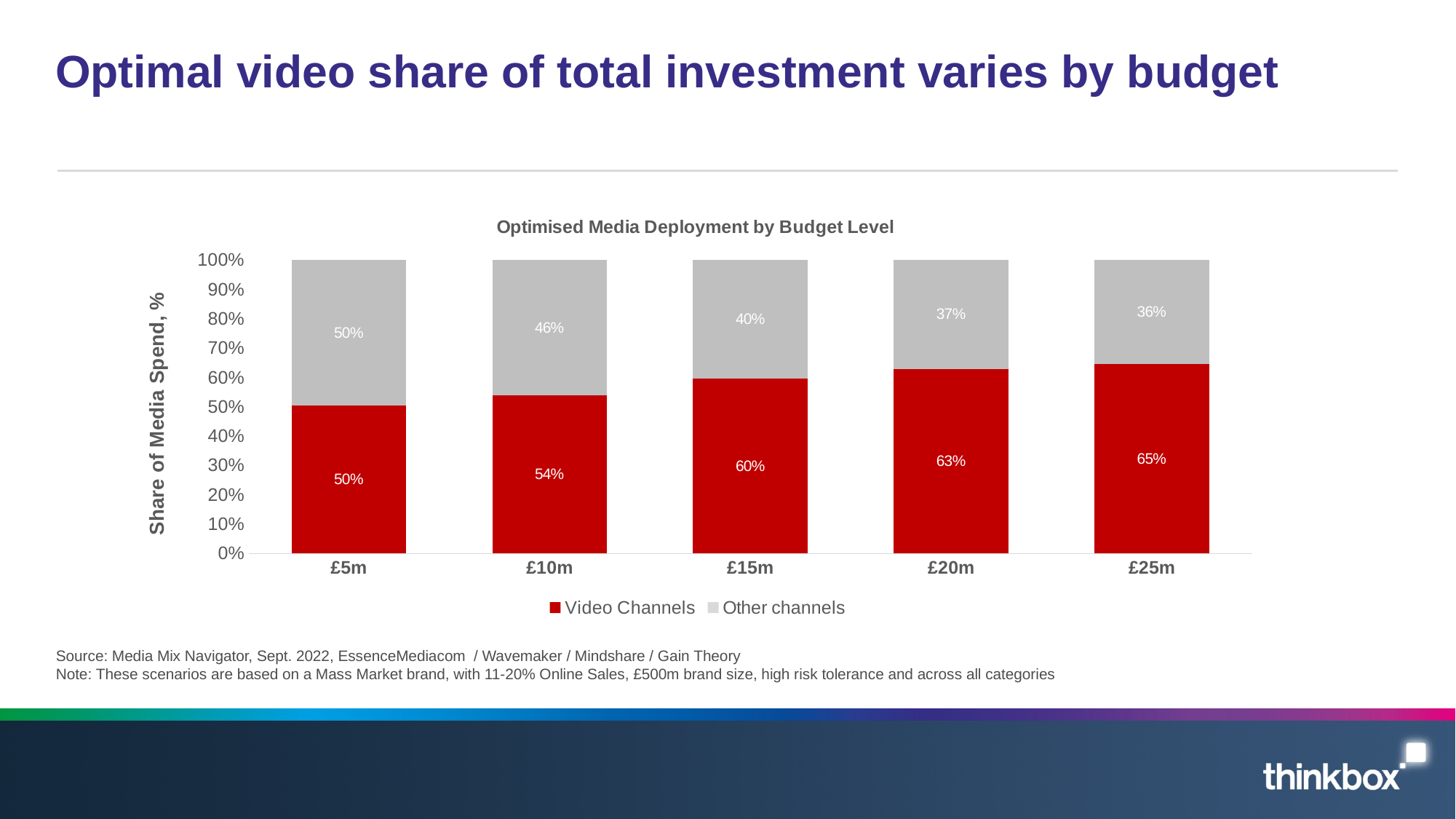
Which is larger: the Video Channels share at £20m or the Other channels share at £20m? Video Channels share at £20m What kind of chart is shown on the slide? Stacked bar chart How many series does the legend list? 2 What is the title of the chart? Optimised Media Deployment by Budget Level What is the difference between the Video Channels share at £25m and at £5m? 15% Which budget level has the lowest Other channels share? £25m What is the Other channels share for the £10m budget level? 46% Does the Video Channels share rise or fall as the budget level increases from £5m to £25m? Rise What is the Video Channels share for the £25m budget level? 65% Which budget level has the highest Video Channels share? £25m What is the Video Channels share for the £15m budget level? 60% How many budget levels are shown on the x axis? 5